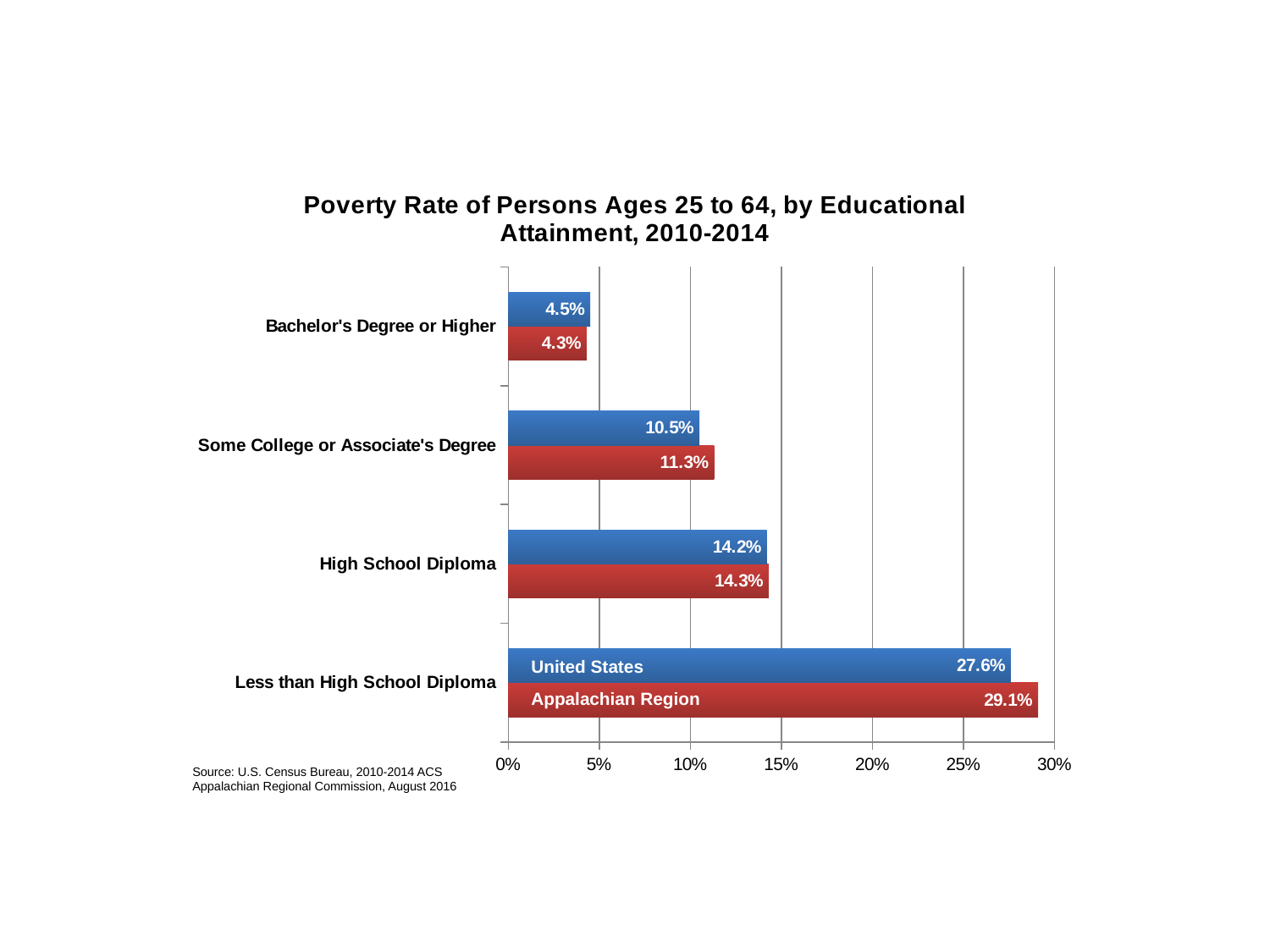
What type of chart is shown on the slide? Bar chart What is the poverty rate for the Appalachian Region among persons with Less than High School Diploma? 29.1% What colour are the bars for the Appalachian Region series? Red How many educational attainment categories are shown in the chart? 4 What is the difference between the Appalachian Region and United States poverty rates for persons with Less than High School Diploma? 1.5% For Some College or Associate's Degree, which is larger: the United States or the Appalachian Region poverty rate? Appalachian Region What is the poverty rate for the Appalachian Region among persons with Some College or Associate's Degree? 11.3% What is the poverty rate for the United States among persons with a Bachelor's Degree or Higher? 4.5% How many data series does the chart show? 2 Which educational attainment category has the lowest poverty rate for the United States? Bachelor's Degree or Higher Which educational attainment category has the highest poverty rate for the Appalachian Region? Less than High School Diploma What is the poverty rate for the United States among persons with a High School Diploma? 14.2%